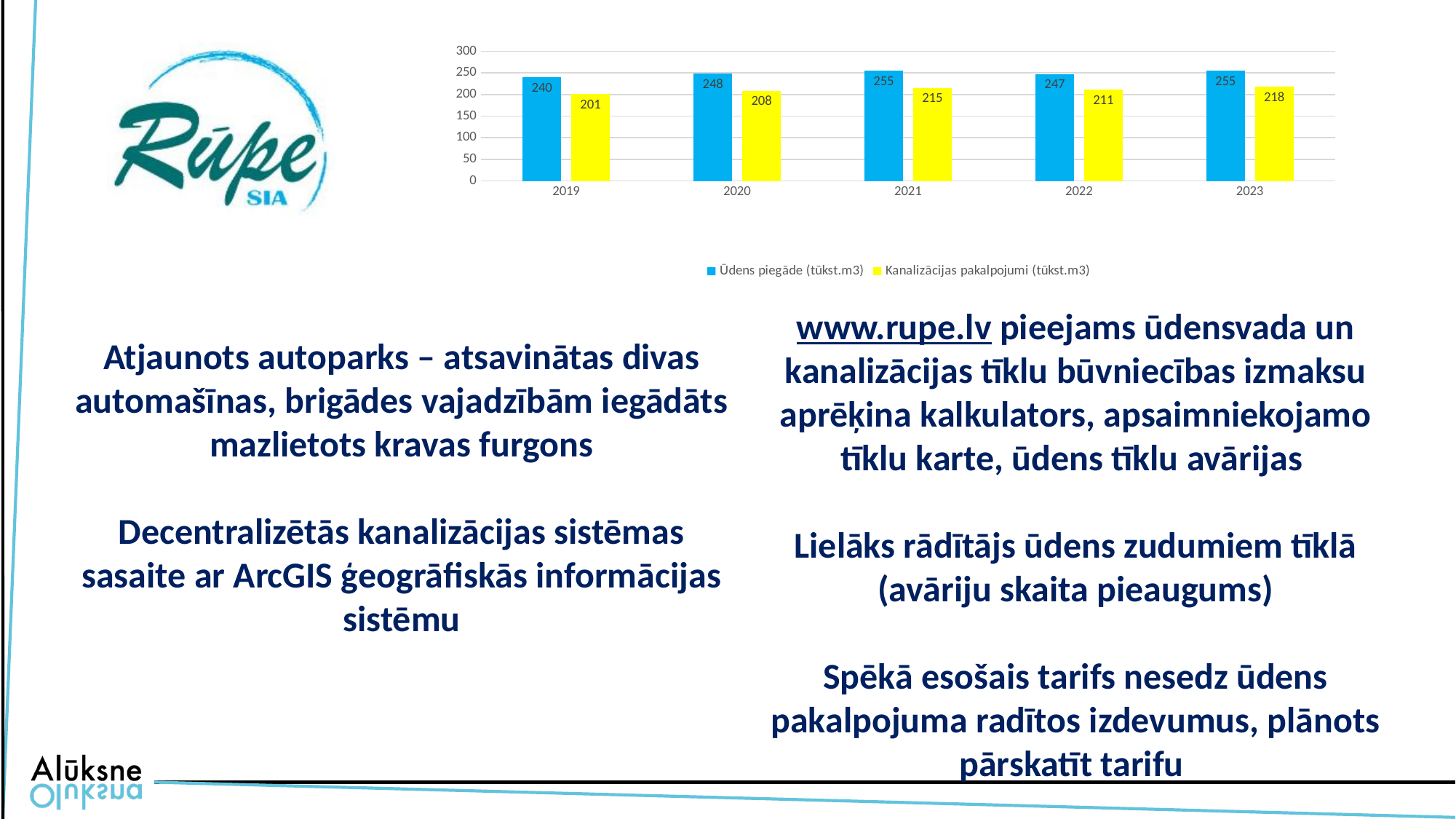
What is the value of Ūdens piegāde (tūkst.m3) in 2019? 240 In which year is Ūdens piegāde (tūkst.m3) lowest? 2019 Which colour represents Kanalizācijas pakalpojumi (tūkst.m3) in the chart? yellow What is the value of Ūdens piegāde (tūkst.m3) in 2023? 255 How many years are shown on the x axis of the chart? 5 How many series does the chart legend list? 2 What is the difference between Ūdens piegāde and Kanalizācijas pakalpojumi in 2021? 40 In which year is Kanalizācijas pakalpojumi (tūkst.m3) highest? 2023 Is the value for Kanalizācijas pakalpojumi in 2019 greater or less than 250? less Which is larger in 2020: Ūdens piegāde or Kanalizācijas pakalpojumi? Ūdens piegāde What kind of chart is shown on the slide? bar chart What is the value of Kanalizācijas pakalpojumi (tūkst.m3) in 2022? 211